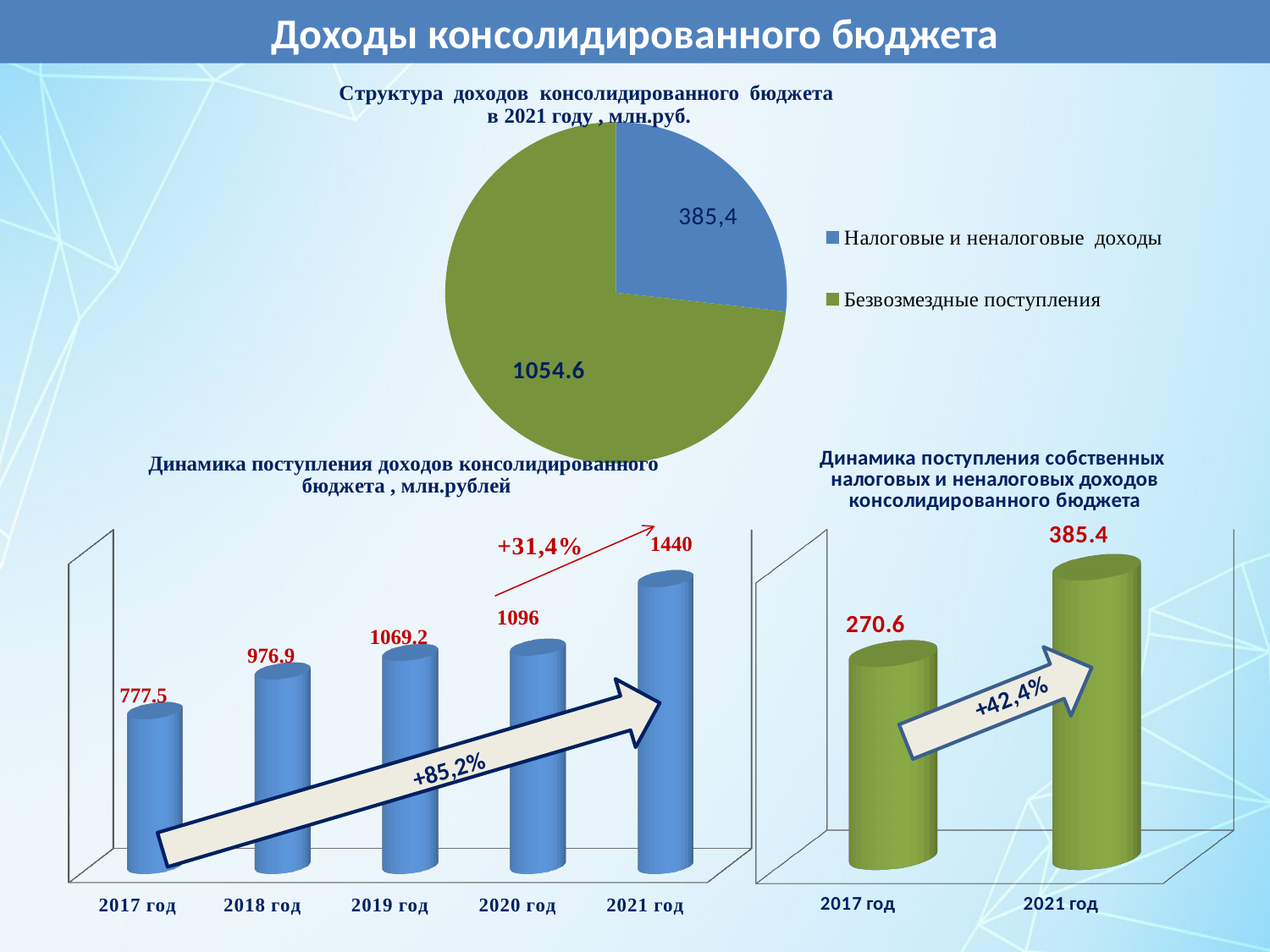
What kind of chart is the chart at the bottom right of the slide? bar chart In the bar chart 'Динамика поступления собственных налоговых и неналоговых доходов консолидированного бюджета', what is the difference between the values for 2021 год and 2017 год? 114.8 In the pie chart at the top of the slide, which category has the larger slice? Безвозмездные поступления How many years are shown in the bar chart 'Динамика поступления доходов консолидированного бюджета, млн.рублей'? 5 In the pie chart 'Структура доходов консолидированного бюджета в 2021 году', what value is shown for 'Безвозмездные поступления'? 1054.6 In the pie chart 'Структура доходов консолидированного бюджета в 2021 году', what value is shown for 'Налоговые и неналоговые доходы'? 385,4 In the bar chart 'Динамика поступления доходов консолидированного бюджета, млн.рублей', which year has the lowest value? 2017 год In the bar chart 'Динамика поступления доходов консолидированного бюджета, млн.рублей', do the values rise or fall from 2017 год to 2021 год? rise In the bar chart 'Динамика поступления доходов консолидированного бюджета, млн.рублей', what is the difference between the values for 2021 год and 2017 год? 662.5 In the bar chart 'Динамика поступления доходов консолидированного бюджета, млн.рублей', what is the value for 2019 год? 1069.2 How many entries does the legend of the pie chart at the top of the slide list? 2 In the bar chart 'Динамика поступления собственных налоговых и неналоговых доходов консолидированного бюджета', what is the value for 2017 год? 270.6